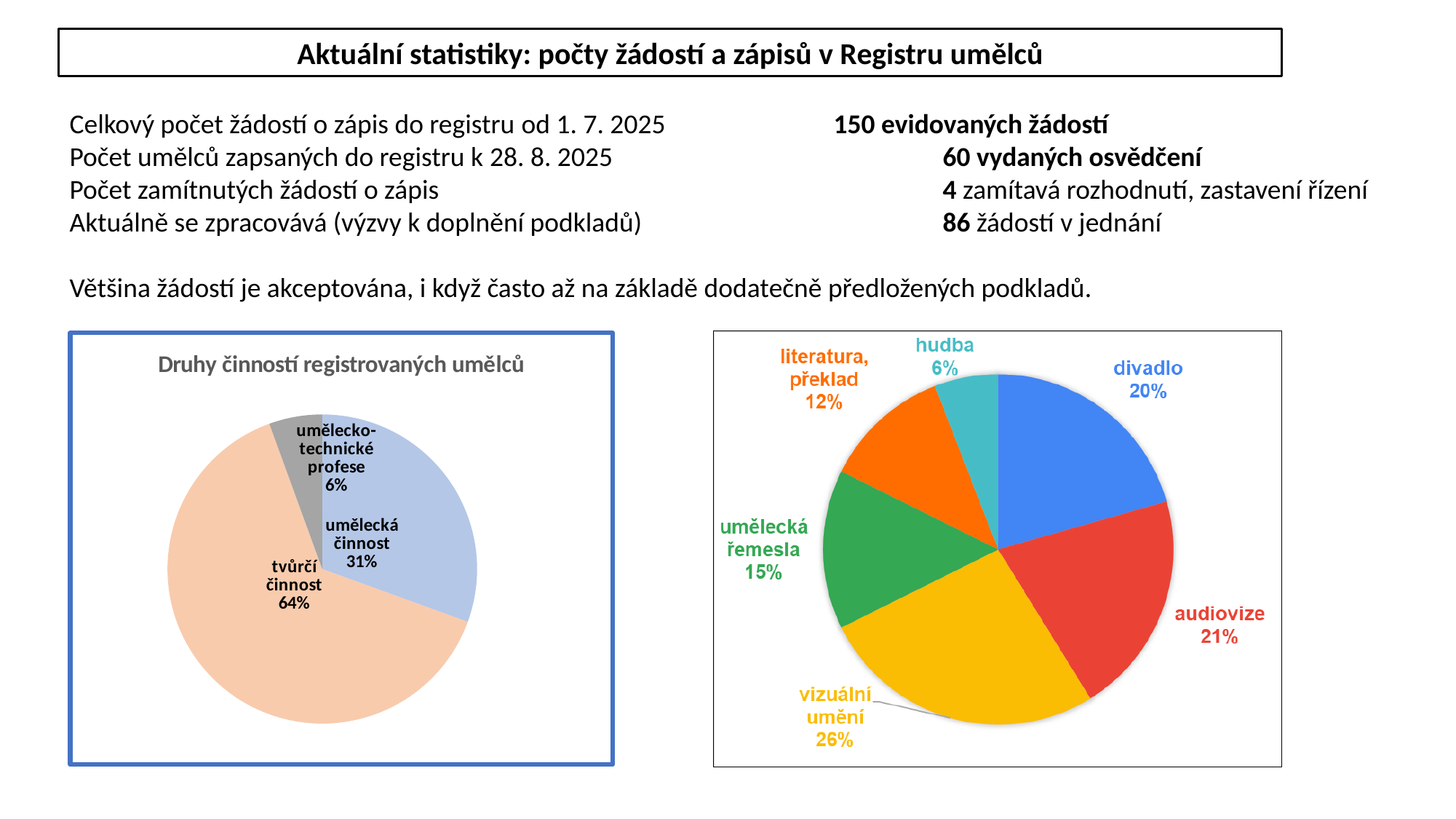
In the pie chart on the right side of the slide, how many slices does the pie have? 6 In the pie chart on the right side of the slide, which category has the smallest share? hudba In the pie chart on the right side of the slide, what share does 'umělecká řemesla' have? 15% What kind of chart is the chart titled 'Druhy činností registrovaných umělců'? pie chart In the chart titled 'Druhy činností registrovaných umělců', what share does 'umělecká činnost' have? 31% In the pie chart on the right side of the slide, which category has the largest share? vizuální umění In the pie chart on the right side of the slide, what share does 'vizuální umění' have? 26% In the pie chart on the right side of the slide, what is the difference in percentage points between 'audiovize' and 'divadlo'? 1 In the chart titled 'Druhy činností registrovaných umělců', how many slices does the pie have? 3 In the chart titled 'Druhy činností registrovaných umělců', which category has the smallest share? umělecko-technické profese In the pie chart on the right side of the slide, what colour is the 'divadlo' slice? blue